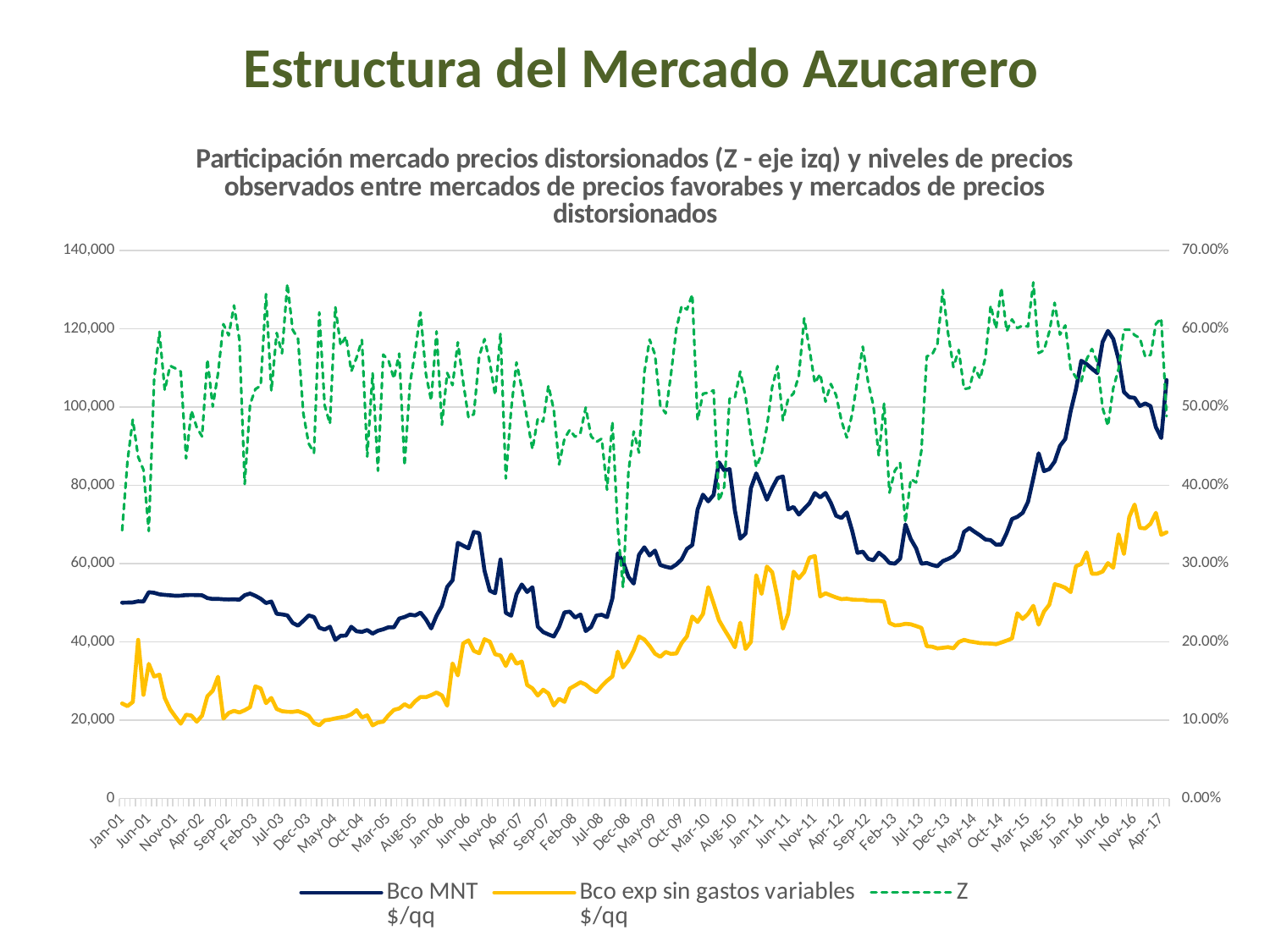
What is the highest value shown on the right-hand axis? 70.00% Is the value of Bco exp sin gastos variables $/qq at Jan-01 greater or less than 40,000? less Overall, does Bco MNT $/qq rise or fall from Jan-01 to Apr-17? rise Is the value of Z at Jan-01 greater or less than 40.00%? less Which series is plotted with a dashed line? Z Is the peak value of Bco MNT $/qq around Jun-16 greater or less than 100,000? greater Which series is higher at Apr-17, Bco MNT $/qq or Bco exp sin gastos variables $/qq? Bco MNT $/qq How many series does the legend list? 3 What kind of chart is shown on the slide? line chart